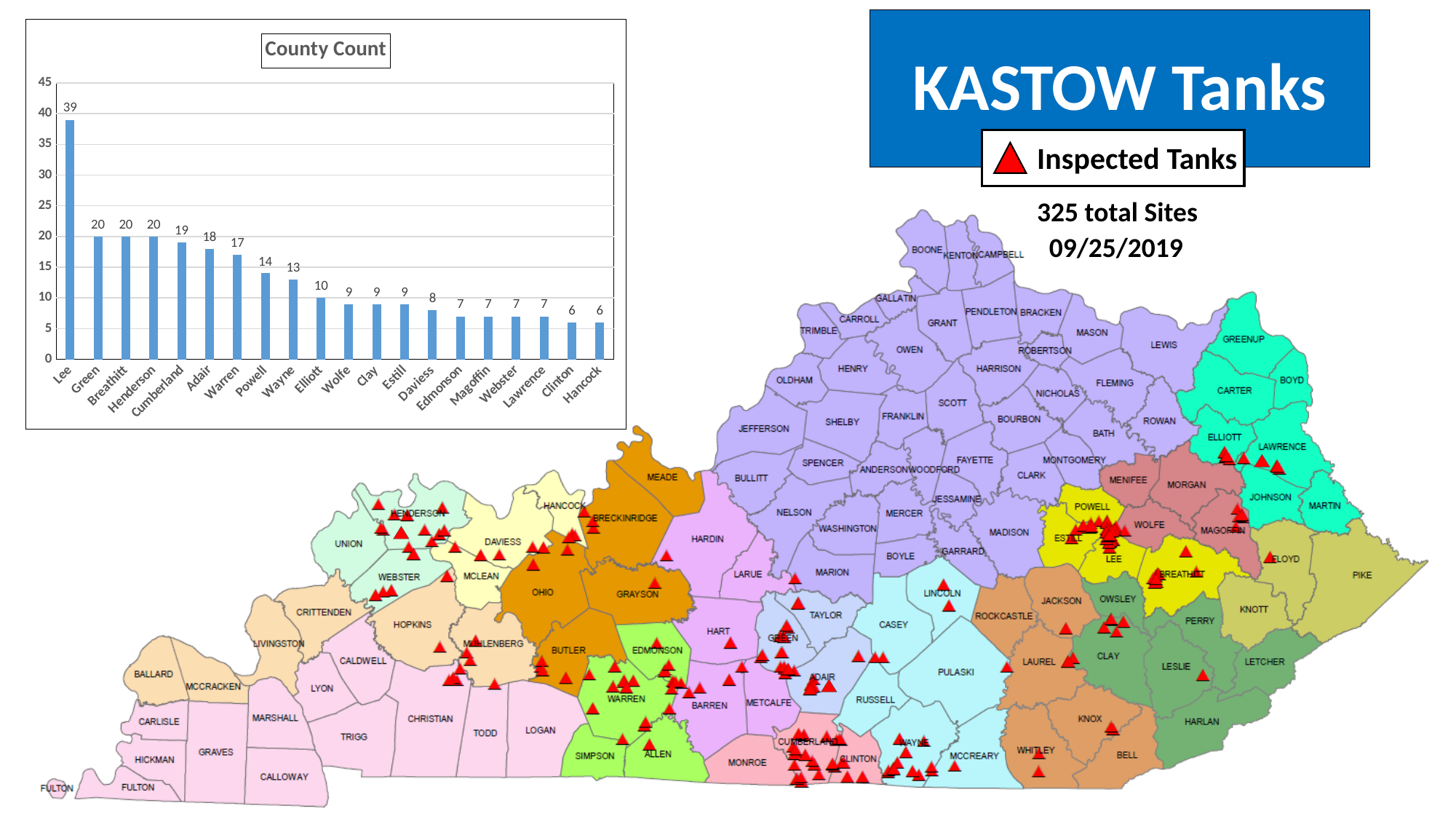
In the County Count chart, which county has the highest count? Lee In the County Count chart, what is the value for Lee? 39 In the County Count chart, what is the value for Daviess? 8 In the County Count chart, what is the difference between the values for Adair and Powell? 4 In the County Count chart, what is the value for Cumberland? 19 In the County Count chart, which is larger, the value for Warren or the value for Elliott? Warren In the County Count chart, is the value for Henderson greater or less than 15? greater In the County Count chart, what is the value for Wayne? 13 In the County Count chart, do the values rise or fall from left to right along the x axis? fall In the County Count chart, what is the difference between the values for Lee and Green? 19 How many counties are shown in the County Count chart? 20 What kind of chart is the County Count chart? bar chart